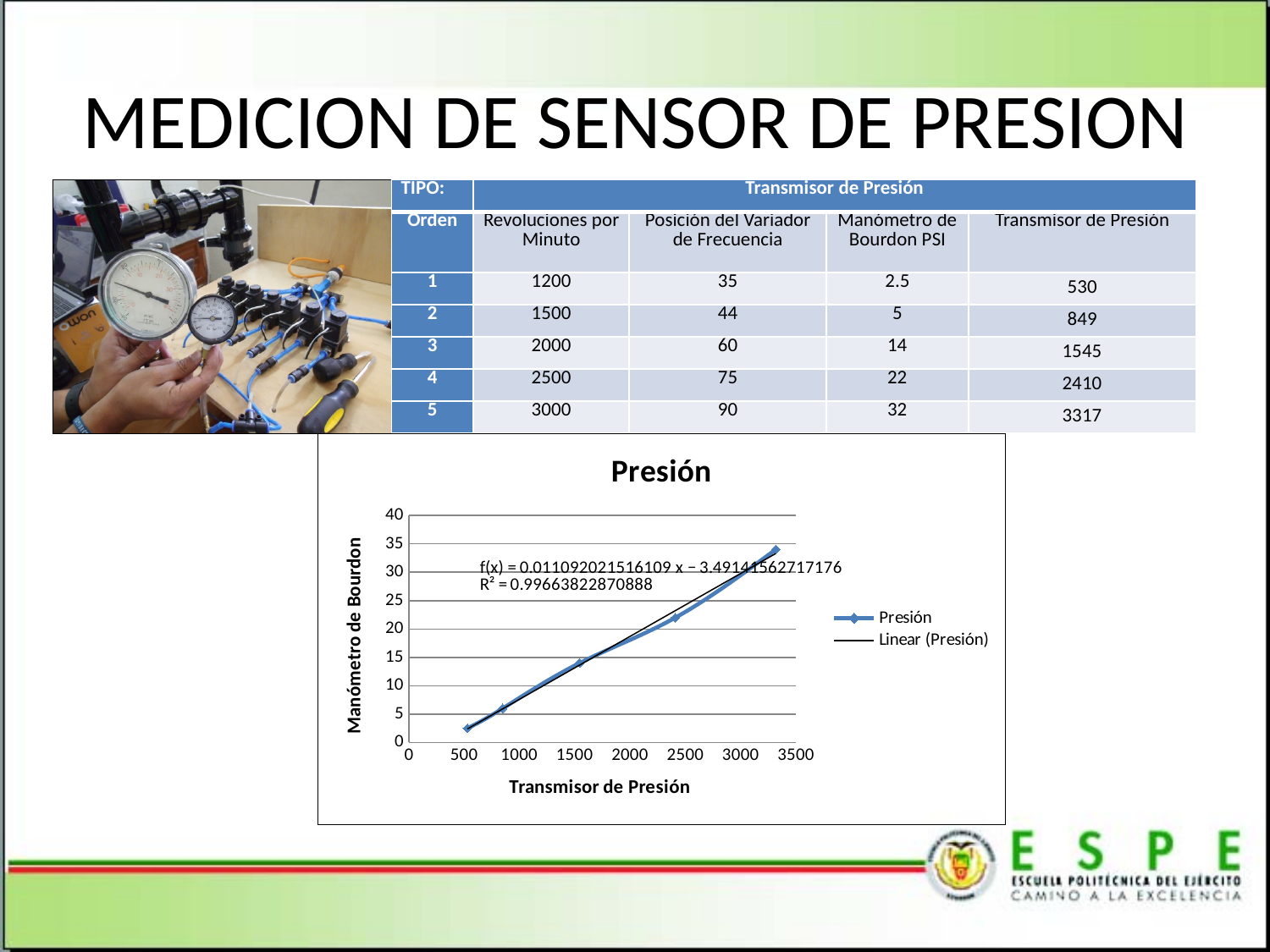
How many data points are plotted for the Presión series? 5 What is the title of the chart? Presión What kind of chart is shown on the slide? scatter chart Which data point has the highest Manómetro de Bourdon value, the leftmost or the rightmost? the rightmost Is the Manómetro de Bourdon value for the leftmost data point greater or less than 5? less What is the maximum value shown on the y axis of the chart? 40 Is the Manómetro de Bourdon value for the data point near 2500 on the x axis greater or less than 20? greater How many series does the chart legend list? 2 Do the Manómetro de Bourdon values rise or fall as Transmisor de Presión increases along the x axis? rise What is the R² value printed on the chart? 0.99663822870888 Is the Manómetro de Bourdon value for the rightmost data point greater or less than 30? greater What is the label of the y axis of the chart? Manómetro de Bourdon